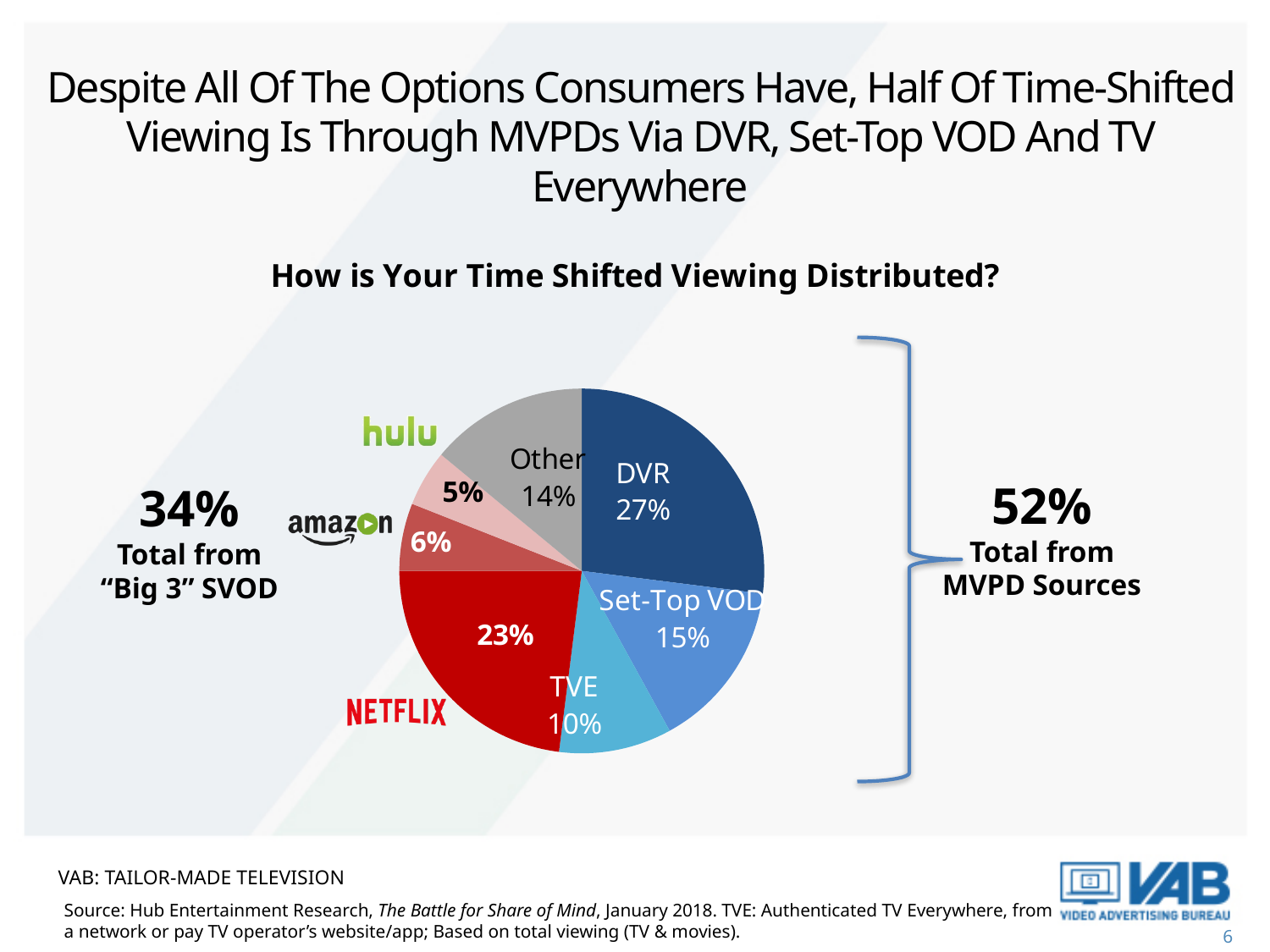
What share of time-shifted viewing is through DVR? 27% Which slice of the pie chart is the smallest? Hulu What share of time-shifted viewing is through Set-Top VOD? 15% What is the title of the chart? How is Your Time Shifted Viewing Distributed? Which slice of the pie chart is the largest? DVR What share of time-shifted viewing is through Hulu? 5% What share of time-shifted viewing is through TVE? 10% How many slices does the pie chart have? 7 What type of chart is shown on the slide? Pie chart What is the difference between the DVR share and the Netflix share? 4% What share of time-shifted viewing is through Netflix? 23%